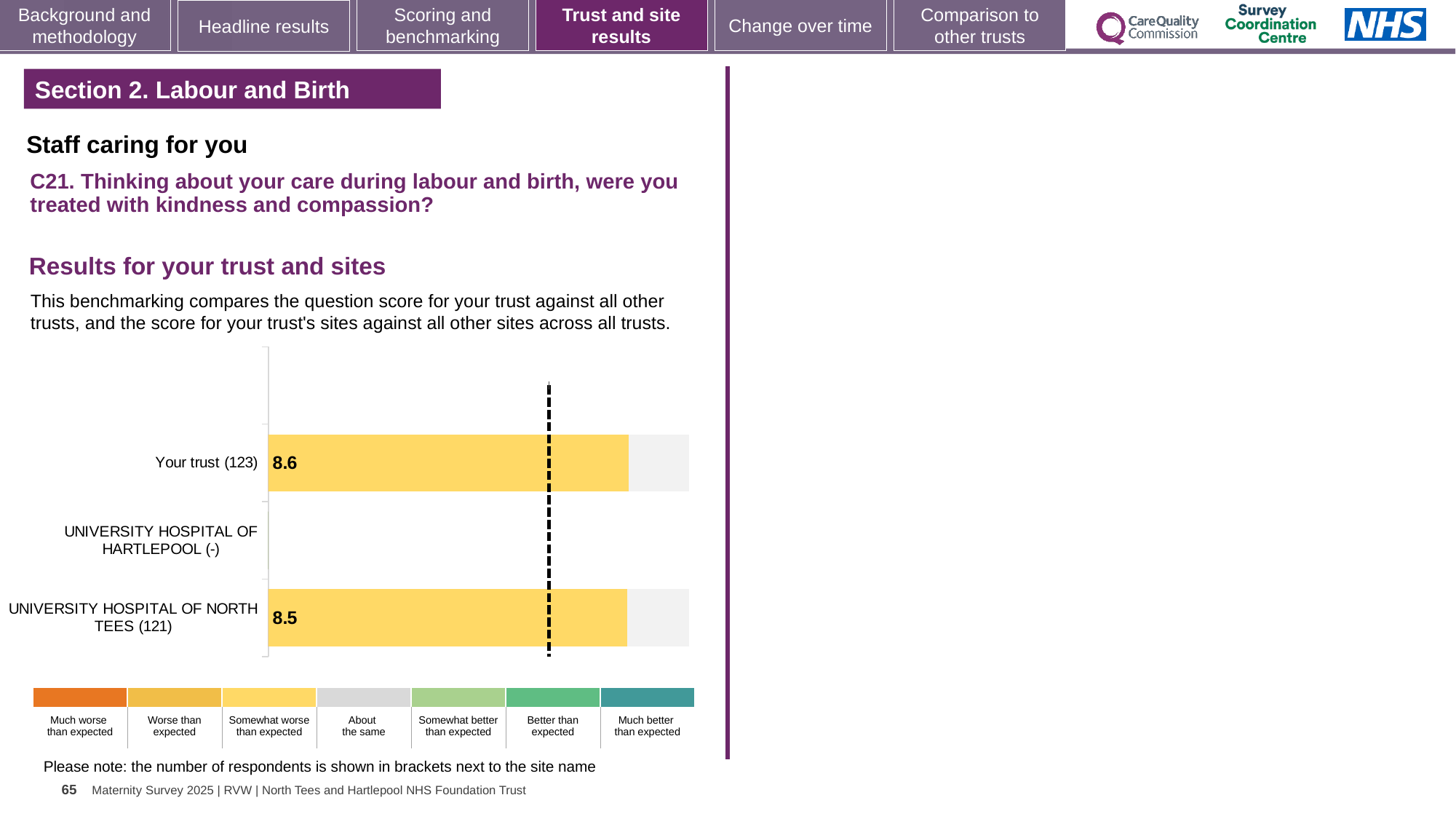
How many respondents are shown in brackets for UNIVERSITY HOSPITAL OF NORTH TEES? 121 How many categories are listed on the chart's vertical axis? 3 What is the score for Your trust (123)? 8.6 Which category has the highest score shown on the chart? Your trust (123) How many respondents are shown in brackets for Your trust? 123 What is the score for UNIVERSITY HOSPITAL OF NORTH TEES (121)? 8.5 Which category on the chart has no bar plotted? UNIVERSITY HOSPITAL OF HARTLEPOOL (-) Which has the larger score, Your trust (123) or UNIVERSITY HOSPITAL OF NORTH TEES (121)? Your trust (123) What is the difference between the score for Your trust (123) and the score for UNIVERSITY HOSPITAL OF NORTH TEES (121)? 0.1 How many rating categories does the colour key below the chart list? 7 According to the colour key, which rating category does the colour of the plotted bars correspond to? Somewhat worse than expected What kind of chart is shown on the slide? Bar chart